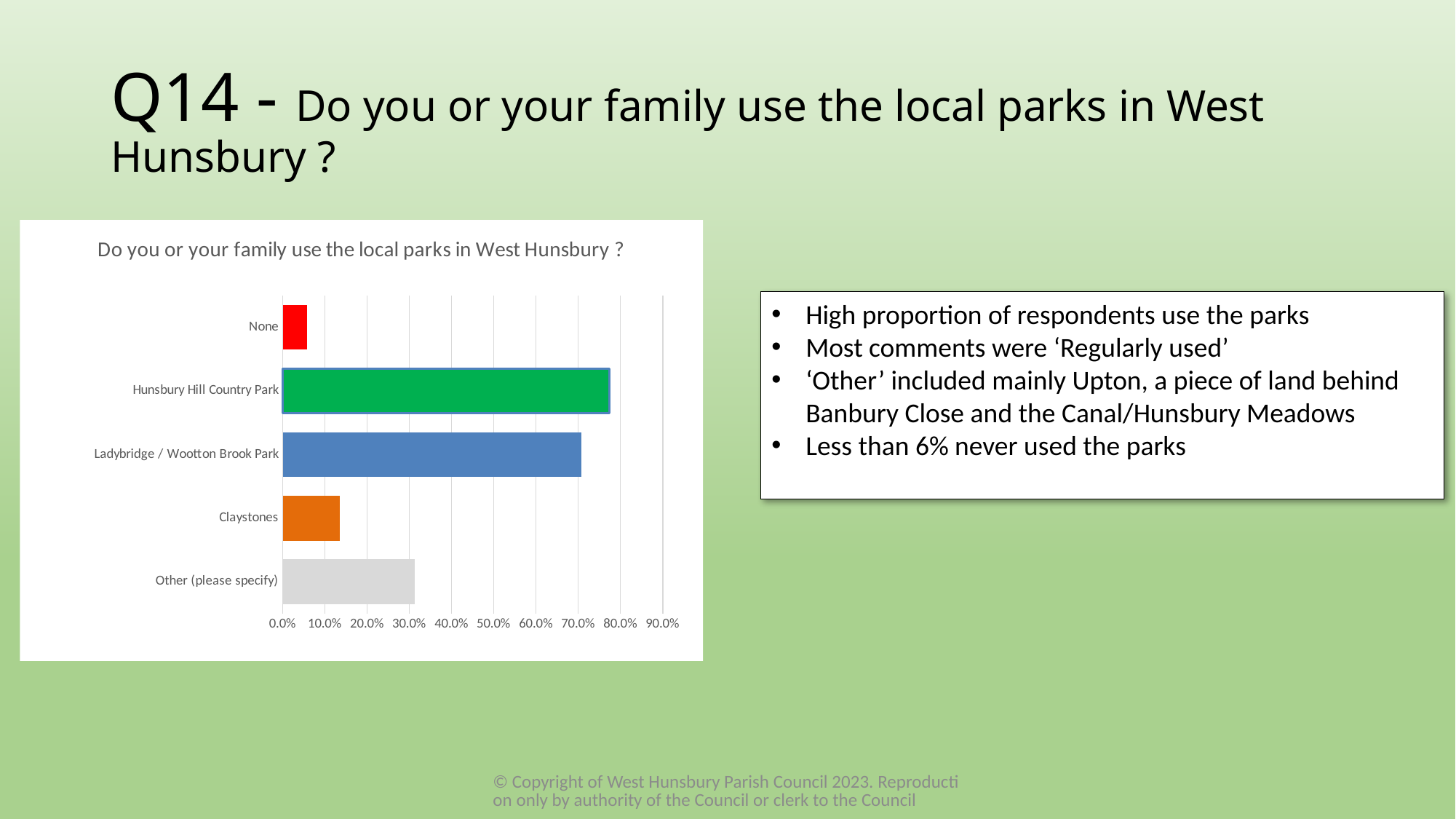
Which is larger, the value for Claystones or the value for Other (please specify)? Other (please specify) Which category has the highest value in the chart? Hunsbury Hill Country Park Is the value for Other (please specify) greater or less than 20.0%? greater Which is larger, the value for Hunsbury Hill Country Park or the value for Ladybridge / Wootton Brook Park? Hunsbury Hill Country Park How many categories are plotted in the chart? 5 Is the value for Claystones greater or less than 20.0%? less What kind of chart is shown on the slide? bar chart Is the value for None greater or less than 10.0%? less Which category has the lowest value in the chart? None What is the title of the chart? Do you or your family use the local parks in West Hunsbury ?